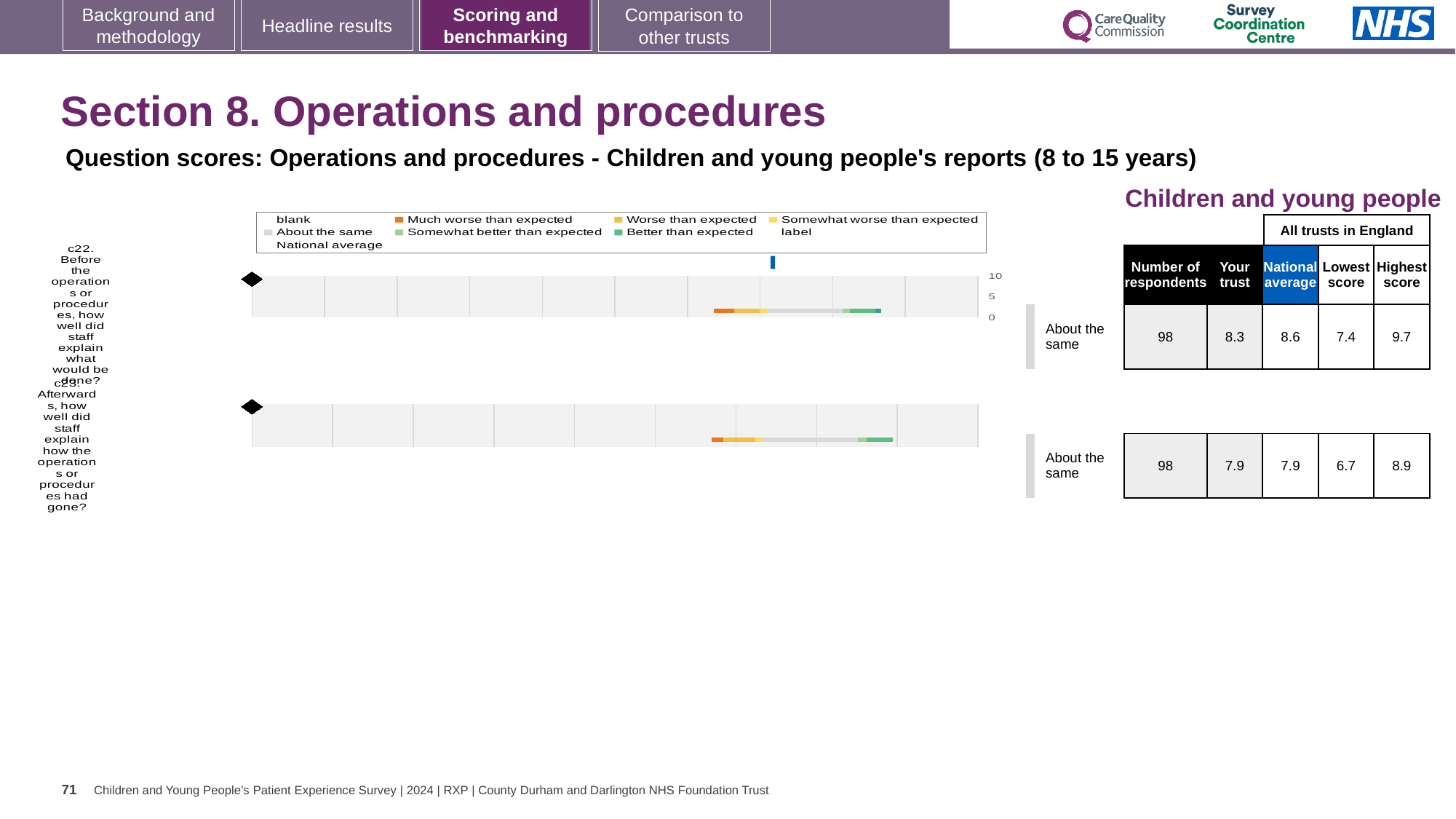
What is the national average score for question c22? 8.6 For question c23, what is the difference between the highest score and the lowest score across all trusts in England? 2.2 What is the lowest score among all trusts in England for question c22? 7.4 How many respondents answered question c23? 98 For question c22, what is the difference between the highest score and the lowest score across all trusts in England? 2.3 For question c22, which is higher: the 'Your trust' score or the national average? National average What benchmark category is shown next to the chart for question c23? About the same What is the highest score among all trusts in England for question c23 (Afterwards, how well did staff explain how the operations or procedures had gone?)? 8.9 How many survey questions are charted on this slide? 2 What is the 'Your trust' score for question c22 (Before the operations or procedures, how well did staff explain what would be done?)? 8.3 For question c22, how much lower is the 'Your trust' score than the national average? 0.3 Which question has the higher 'Your trust' score, c22 or c23? c22